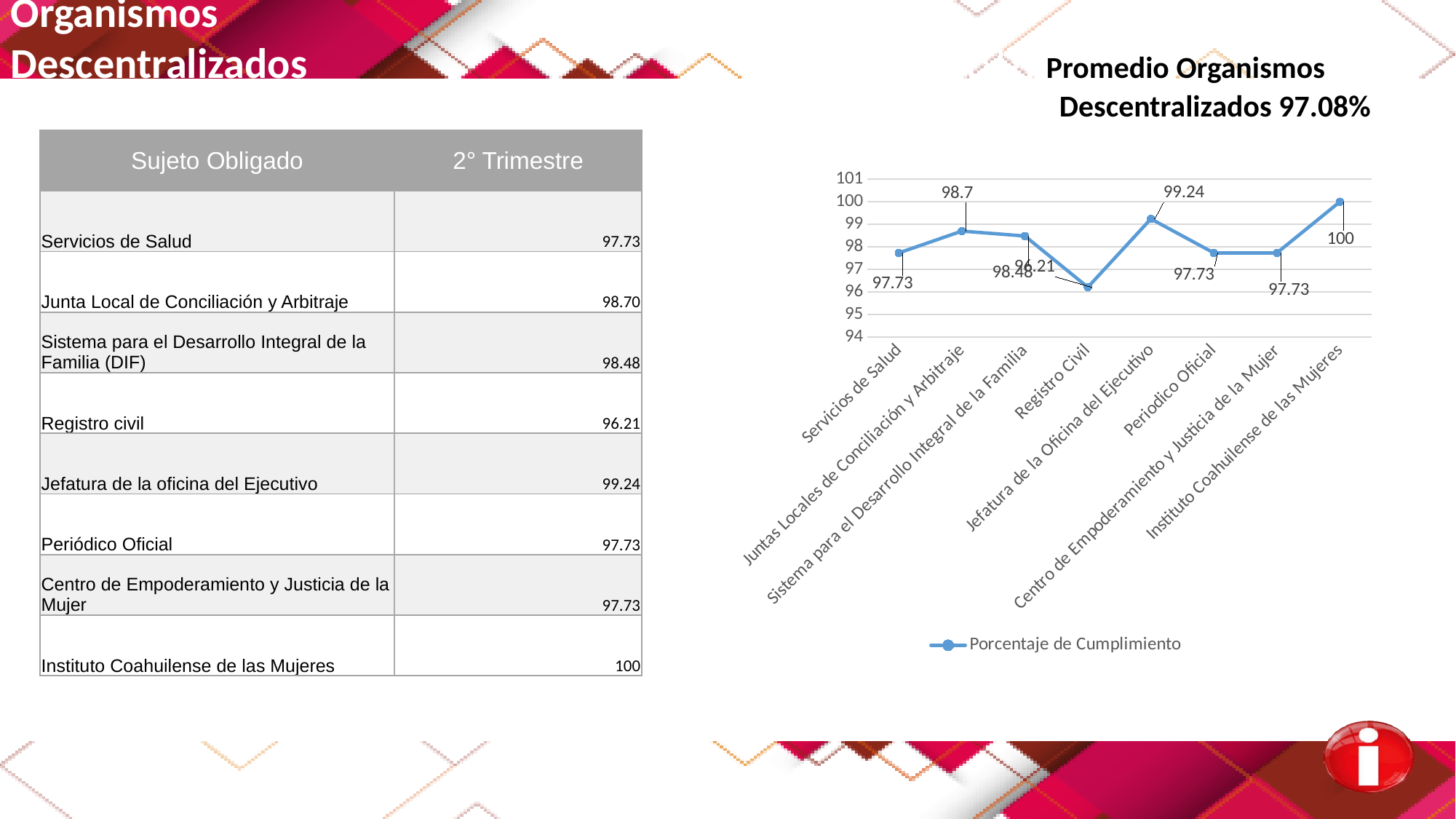
What is the value for Juntas Locales de Conciliación y Arbitraje in the chart? 98.7 Which category has the highest value in the chart? Instituto Coahuilense de las Mujeres How many categories are plotted on the x axis of the chart? 8 What is the value for Jefatura de la Oficina del Ejecutivo in the chart? 99.24 What type of chart is shown on the slide? line chart How many series does the chart legend list? 1 What is the value for Servicios de Salud in the chart? 97.73 What is the name of the series shown in the chart legend? Porcentaje de Cumplimiento Which is larger, the value for Jefatura de la Oficina del Ejecutivo or the value for Periodico Oficial? Jefatura de la Oficina del Ejecutivo What is the value for Registro Civil in the chart? 96.21 What is the difference between the values for Instituto Coahuilense de las Mujeres and Registro Civil? 3.79 Which category has the lowest value in the chart? Registro Civil